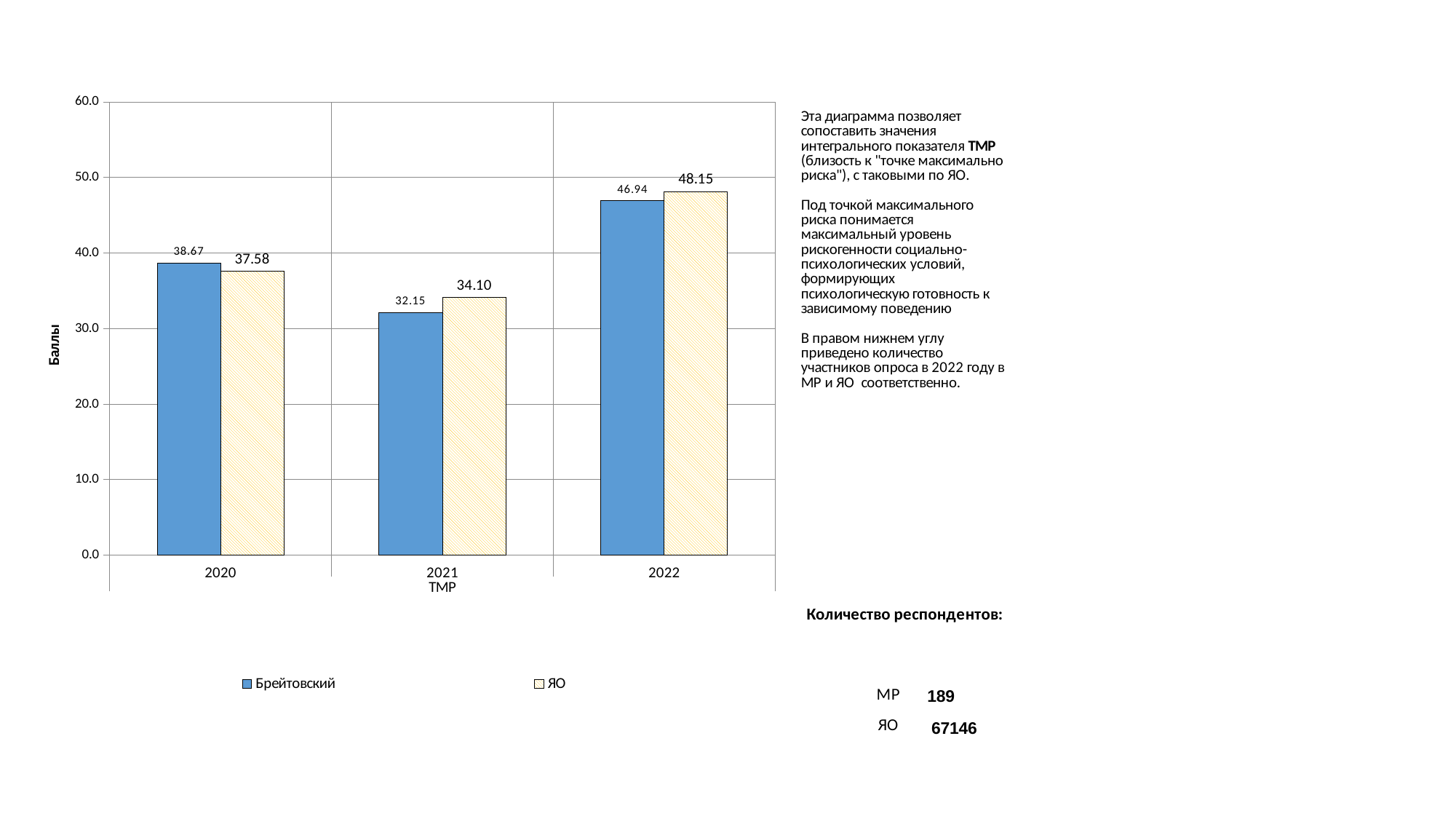
Which is larger in 2020, the Брейтовский value or the ЯО value? Брейтовский What kind of chart is shown on the slide? Bar chart How many years are shown on the x axis? 3 What is the difference between the ЯО and Брейтовский values in 2022? 1.21 What is the value for Брейтовский in 2021? 32.15 How many series does the legend list? 2 What is the label of the vertical axis? Баллы In which year is the ЯО value lowest? 2021 What is the value for ЯО in 2021? 34.10 What is the value for Брейтовский in 2020? 38.67 What is the value for ЯО in 2022? 48.15 In which year is the Брейтовский value highest? 2022